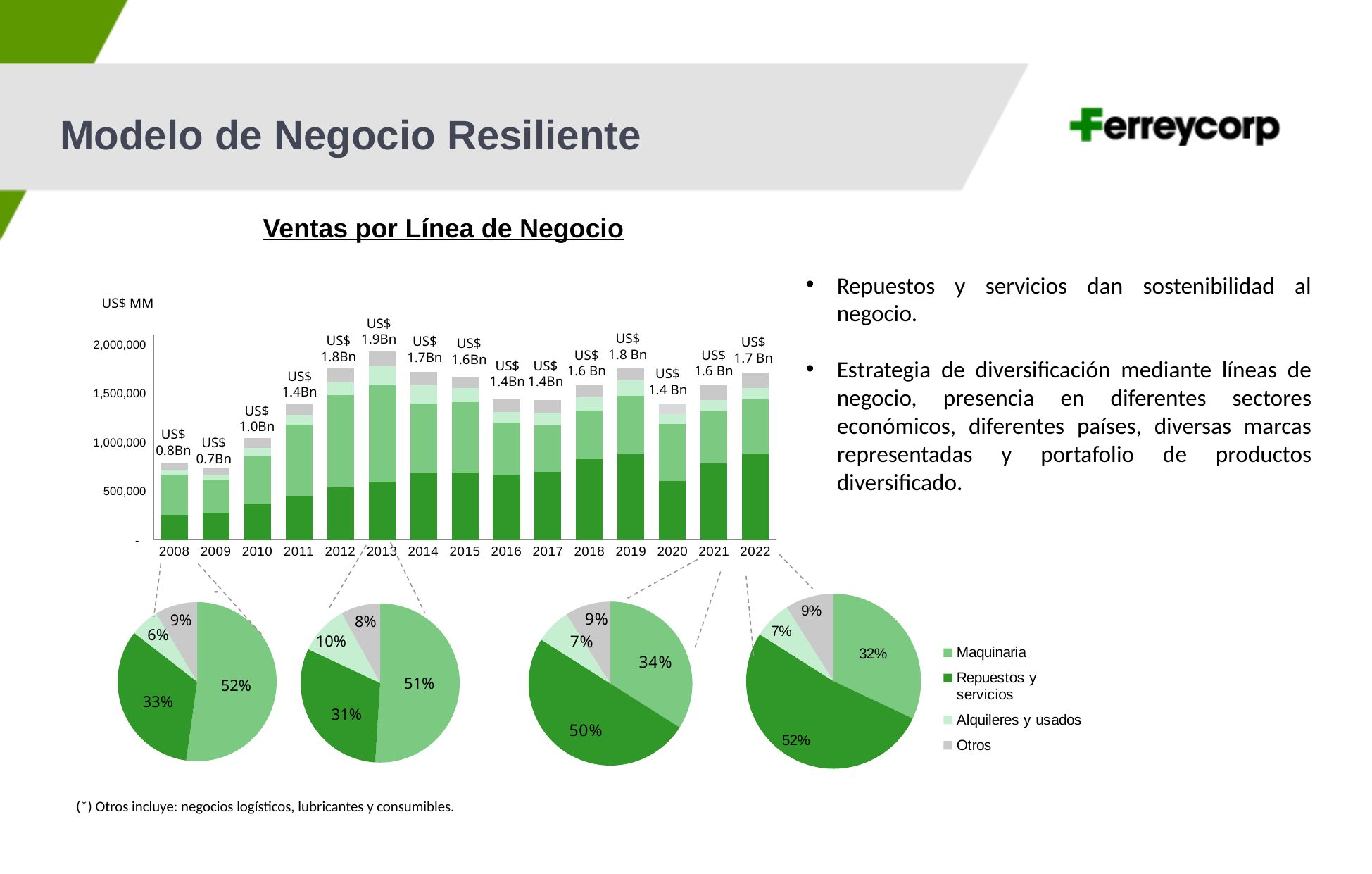
How many years are shown on the x axis of the bar chart? 15 In the leftmost pie chart, what share does Maquinaria have? 52% In the rightmost pie chart, what share does Repuestos y servicios have? 52% In the third pie chart from the left, which business line has the largest slice? Repuestos y servicios In the bar chart, is the labelled total for 2022 larger or smaller than the total for 2021? Larger How many business lines does the legend next to the pie charts list? 4 In the bar chart, what total sales value is labelled for 2013? US$ 1.9Bn In the bar chart, which year has the lowest labelled total sales? 2009 In the bar chart, what total sales value is labelled for 2008? US$ 0.8Bn In the bar chart, which year has the highest labelled total sales? 2013 What kind of chart is the 'Ventas por Línea de Negocio' chart with years on the x axis? Stacked bar chart In the second pie chart from the left, what share does Alquileres y usados have? 10%